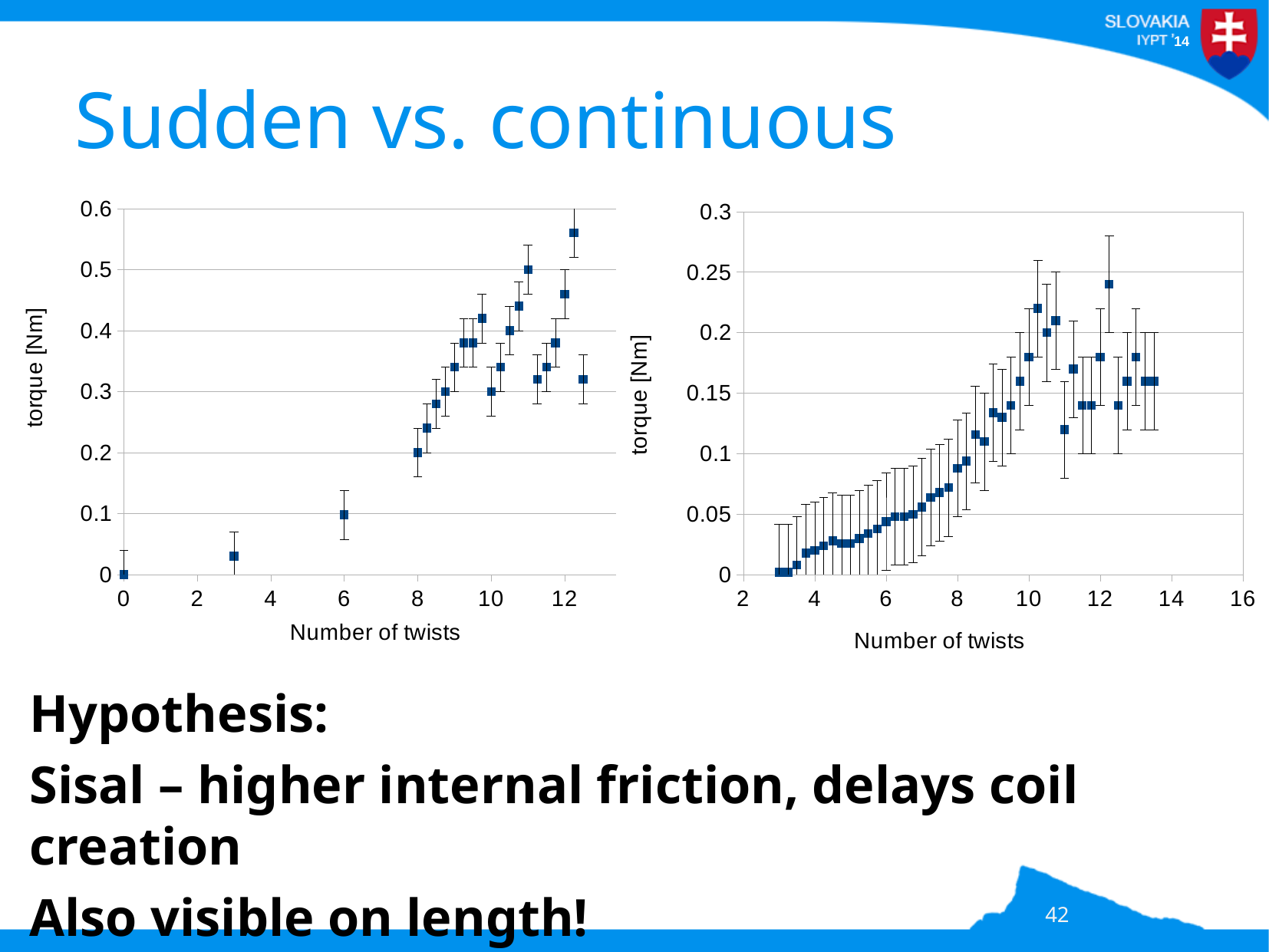
On the left chart, which has the larger torque: the point at 6 twists or the point at 8 twists? 8 twists What is the label of the x axis on the right chart? Number of twists What is the maximum value shown on the y axis of the right chart? 0.3 What kind of chart is the left chart? scatter chart On the right chart, is the highest plotted torque value greater or less than 0.2? greater On the right chart, does torque generally rise or fall as the number of twists increases? rise On the left chart, what is the torque value at 0 twists? 0 On the right chart, is the torque value at 6 twists greater or less than 0.1? less On the left chart, is the highest plotted torque value greater or less than 0.5? greater What is the label of the y axis on the left chart? torque [Nm]